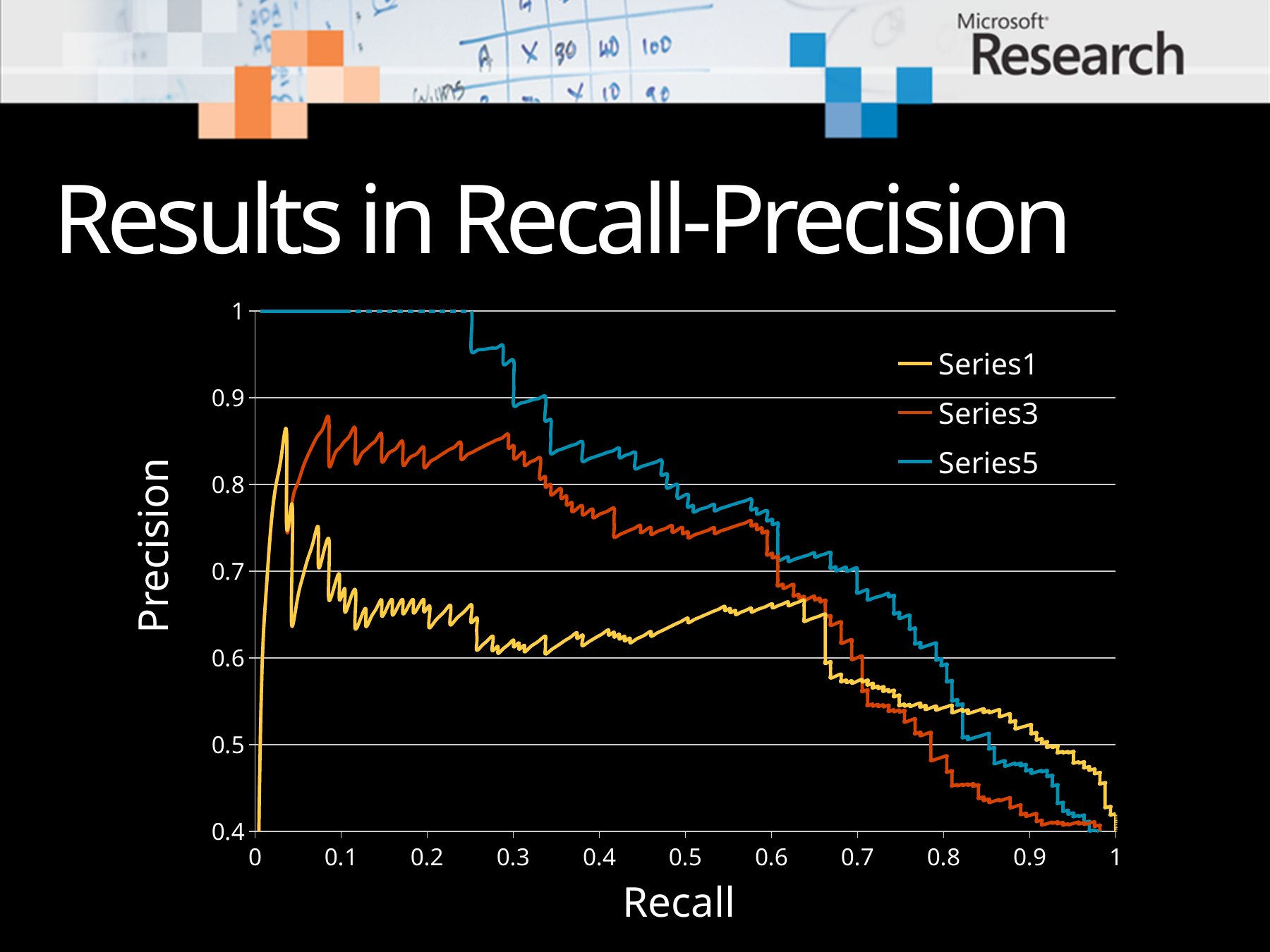
What are the labels of the x axis and y axis of the chart? Recall (x axis) and Precision (y axis) Is the precision of Series3 at recall 0.9 greater or less than 0.5? less What kind of chart is shown on the slide? Line chart Is the precision of Series1 at recall 0.5 greater or less than 0.6? greater How many series does the chart legend list? 3 Is the precision of Series3 at recall 0.2 greater or less than 0.8? greater At recall 0.9, which series has higher precision, Series1 or Series3? Series1 Which series has the lowest precision at recall 0.1? Series1 At recall 0.2, which series has higher precision, Series1 or Series5? Series5 What is the title of the slide containing the chart? Results in Recall-Precision What is the precision of Series5 at recall 0.1? 1